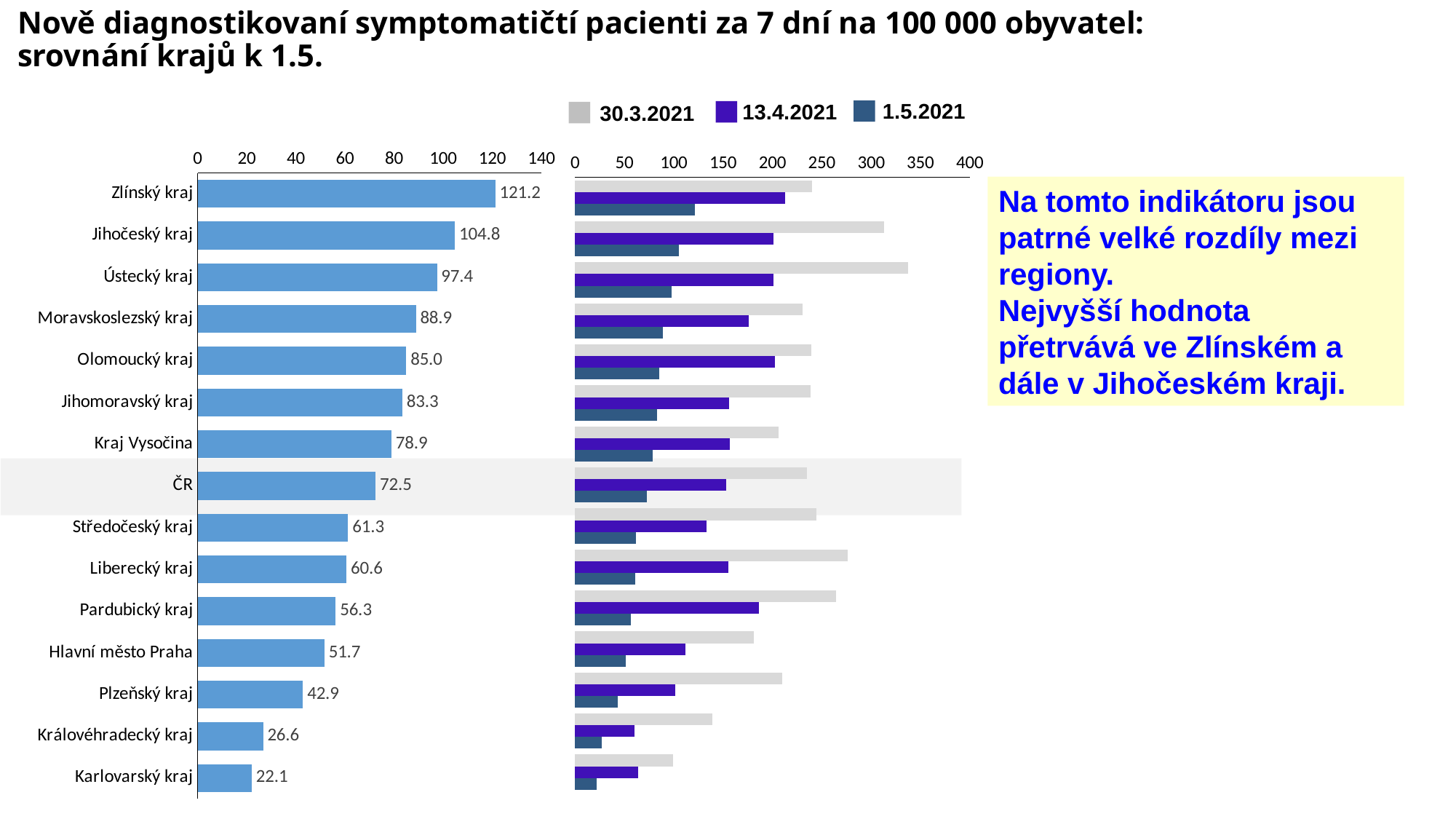
In the left chart, what is the difference between the values for Zlínský kraj and Jihočeský kraj? 16.4 In the left chart, which region has the lowest value? Karlovarský kraj How many series does the legend of the right chart list? 3 In the left chart, what is the value for Zlínský kraj? 121.2 In the left chart, what is the value for ČR? 72.5 In the left chart, which region has the highest value? Zlínský kraj In the left chart, what is the difference between the values for ČR and Středočeský kraj? 11.2 In the left chart, which is larger: the value for Pardubický kraj or the value for Plzeňský kraj? Pardubický kraj In the left chart, what is the value for Hlavní město Praha? 51.7 What kind of chart is the left chart? bar chart How many categories (rows) are shown in the left chart? 15 In the right chart, is the 30.3.2021 value for Ústecký kraj greater or less than 300? greater